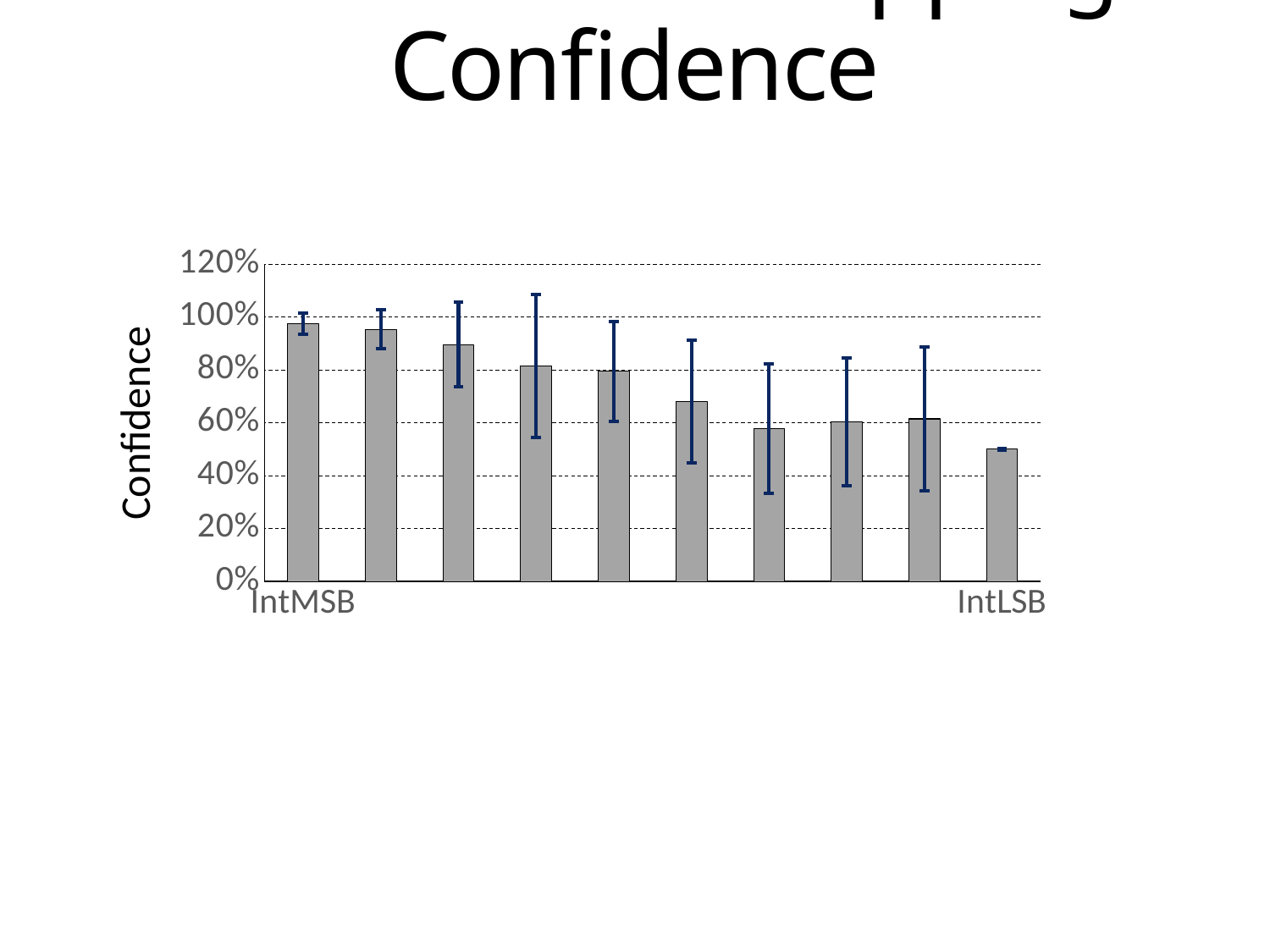
What is the highest tick value shown on the vertical axis? 120% Which labelled category has the lowest bar? IntLSB What kind of chart is shown on the slide? bar chart What is the label on the vertical axis of the chart? Confidence Which has the larger value, IntMSB or IntLSB? IntMSB How many bars are plotted in the chart? 10 Do the bar values generally rise or fall from IntMSB to IntLSB along the x axis? fall Is the value for IntLSB greater or less than 40%? greater Is the value for IntMSB greater or less than 80%? greater Is the value for IntLSB greater or less than 60%? less